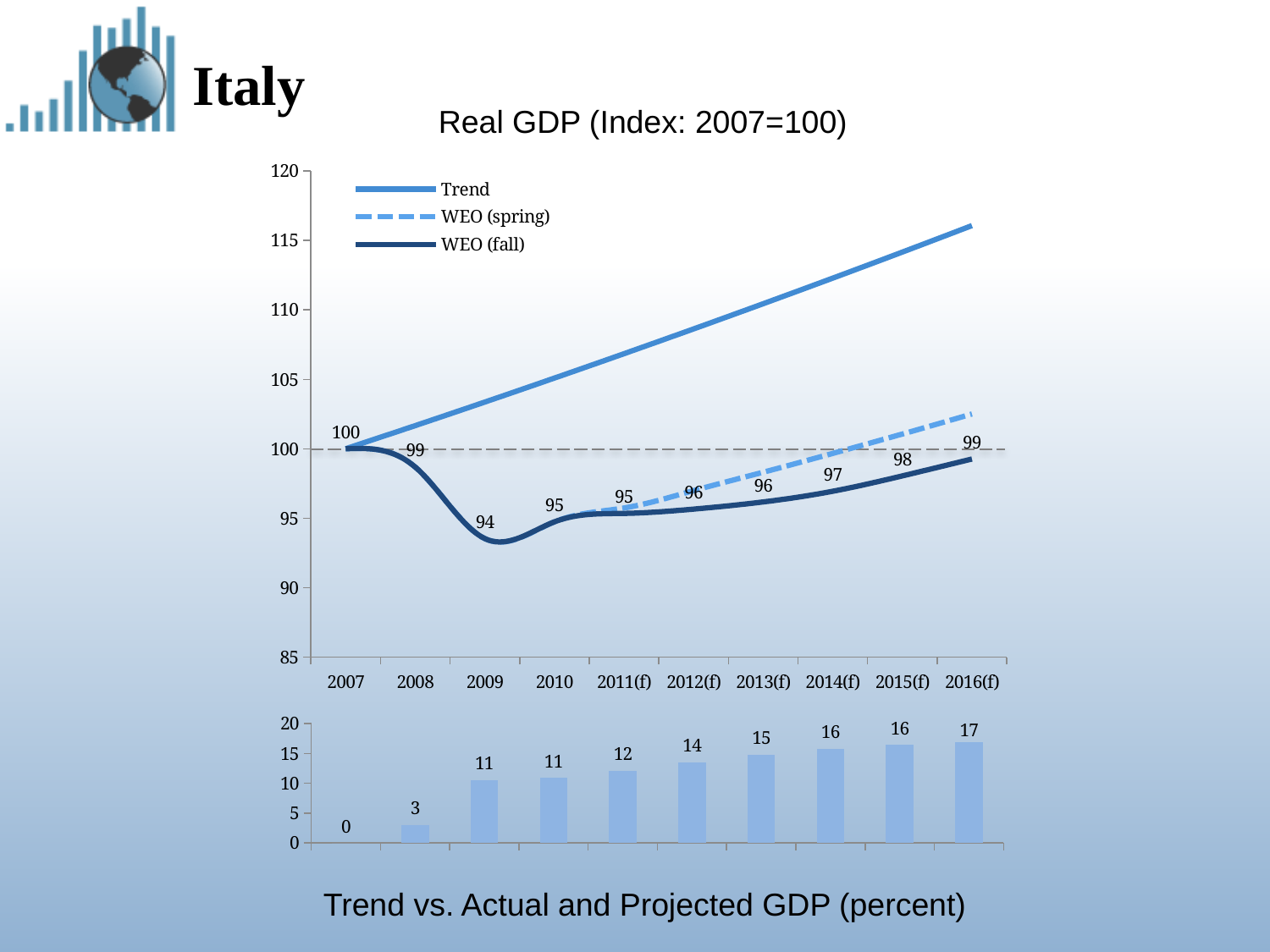
In the Real GDP (Index: 2007=100) chart, what is the WEO (fall) value for 2009? 94 In the Real GDP (Index: 2007=100) chart, which series is drawn with a dashed line? WEO (spring) What kind of chart is the Trend vs. Actual and Projected GDP (percent) chart? Bar chart In the Real GDP (Index: 2007=100) chart, what is the difference between the WEO (fall) values for 2007 and 2009? 6 In the Trend vs. Actual and Projected GDP (percent) chart, which year has the highest value? 2016(f) In the Real GDP (Index: 2007=100) chart, how many series does the legend list? 3 In the Real GDP (Index: 2007=100) chart, is the Trend value for 2016(f) greater or less than 115? greater In the Real GDP (Index: 2007=100) chart, which year has the lowest WEO (fall) value? 2009 In the Trend vs. Actual and Projected GDP (percent) chart, how many bars are shown? 10 In the Real GDP (Index: 2007=100) chart, what is the WEO (fall) value for 2016(f)? 99 In the Trend vs. Actual and Projected GDP (percent) chart, do the values generally rise or fall from 2007 to 2016(f)? Rise In the Trend vs. Actual and Projected GDP (percent) chart, what is the value for 2008? 3